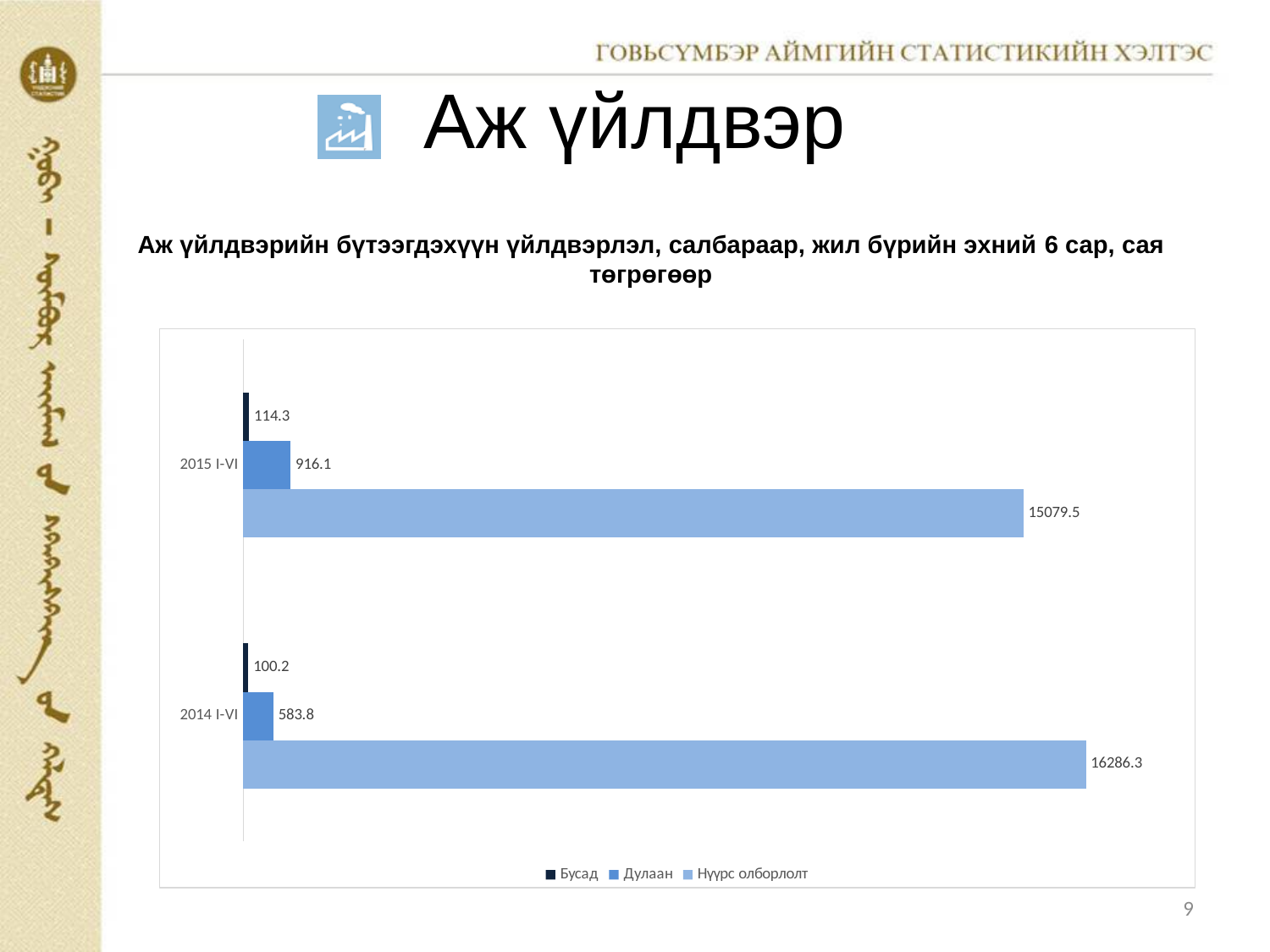
Which series has the lowest value in 2015 I-VI? Бусад What is the value for Нүүрс олборлолт in 2015 I-VI? 15079.5 Which series has the highest value in 2014 I-VI? Нүүрс олборлолт How many series does the legend list? 3 What is the value for Дулаан in 2014 I-VI? 583.8 What is the value for Нүүрс олборлолт in 2014 I-VI? 16286.3 How many categories (periods) are shown on the chart? 2 What is the value for Бусад in 2015 I-VI? 114.3 What is the difference between the Дулаан values for 2015 I-VI and 2014 I-VI? 332.3 Which series is shown in the darkest colour in the legend? Бусад What type of chart is shown on the slide? bar chart Which is larger: Нүүрс олборлолт in 2014 I-VI or in 2015 I-VI? 2014 I-VI